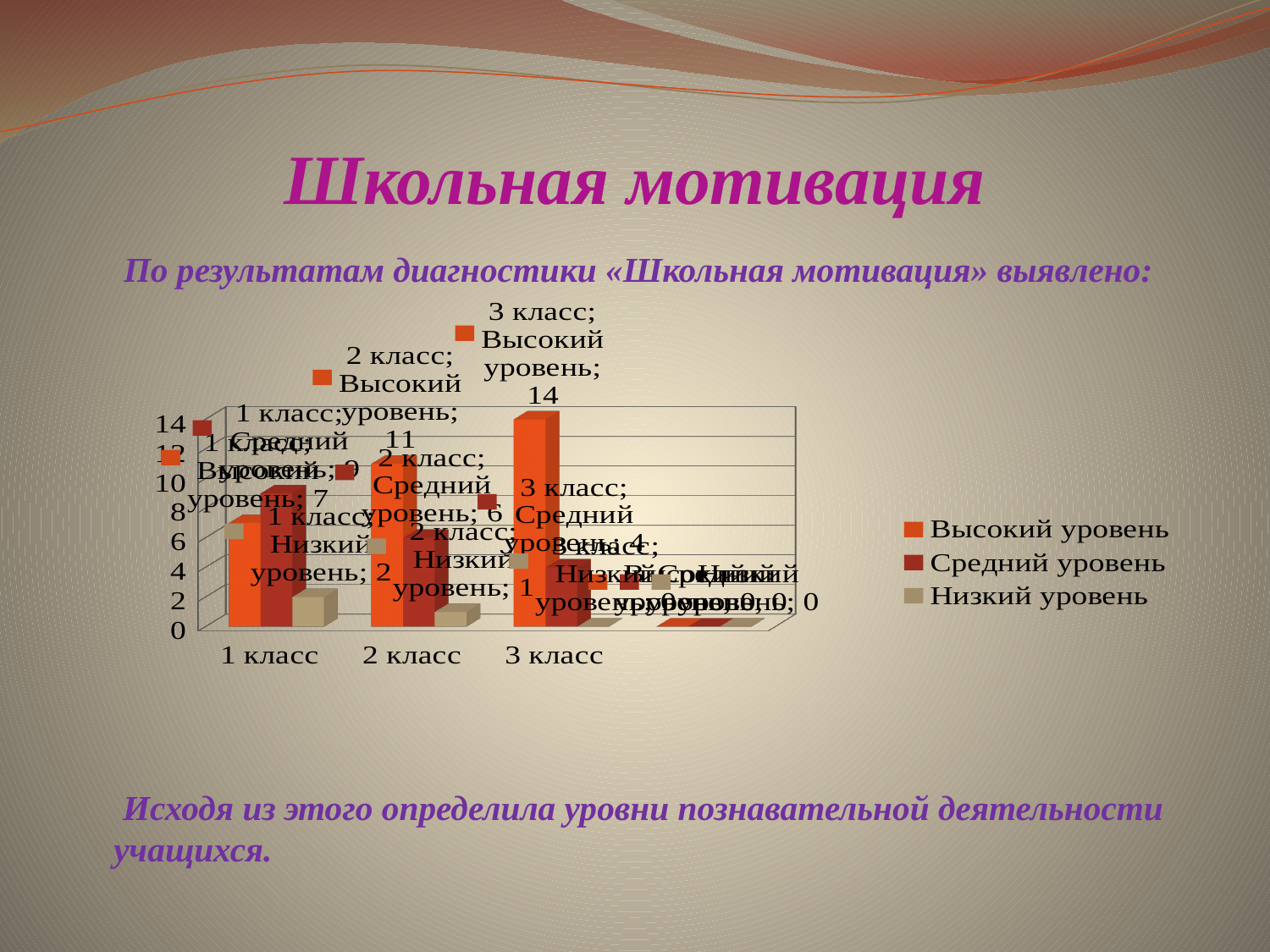
Which class has the highest value for Высокий уровень? 3 класс Does the value for Высокий уровень rise or fall from 1 класс to 3 класс? Rise Which is larger in 1 класс: Высокий уровень or Средний уровень? Средний уровень How many series does the legend list? 3 What is the value for Средний уровень in 1 класс? 9 What kind of chart is shown on the slide? Bar chart What is the value for Средний уровень in 3 класс? 4 What is the value for Низкий уровень in 2 класс? 1 What is the difference between the Высокий уровень values for 3 класс and 1 класс? 7 What is the value for Высокий уровень in 3 класс? 14 Which class has the lowest value for Низкий уровень? 3 класс What is the value for Высокий уровень in 2 класс? 11